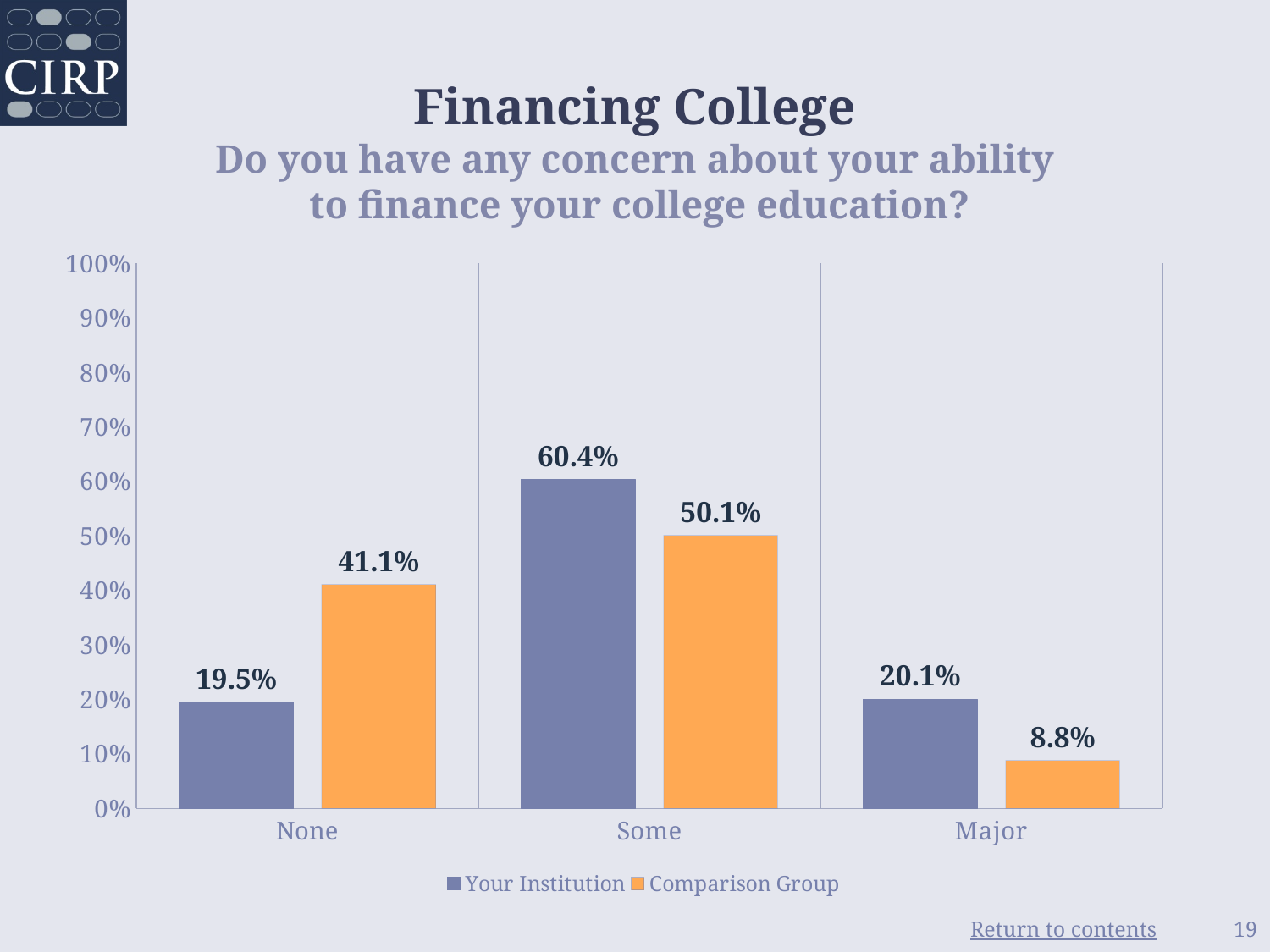
What is the difference between Comparison Group and Your Institution in the None category? 21.6% In the Major category, which series has the larger value, Your Institution or Comparison Group? Your Institution What is the difference between Your Institution and Comparison Group in the Some category? 10.3% Which category has the lowest value for Comparison Group? Major How many categories are shown on the x axis? 3 Which category has the highest value for Your Institution? Some What is the value for Comparison Group in the Some category? 50.1% What is the value for Your Institution in the None category? 19.5% What kind of chart is shown on the slide? bar chart How many series does the legend list? 2 What is the value for Comparison Group in the Major category? 8.8% Is the value for Comparison Group in the None category greater or less than 50%? less